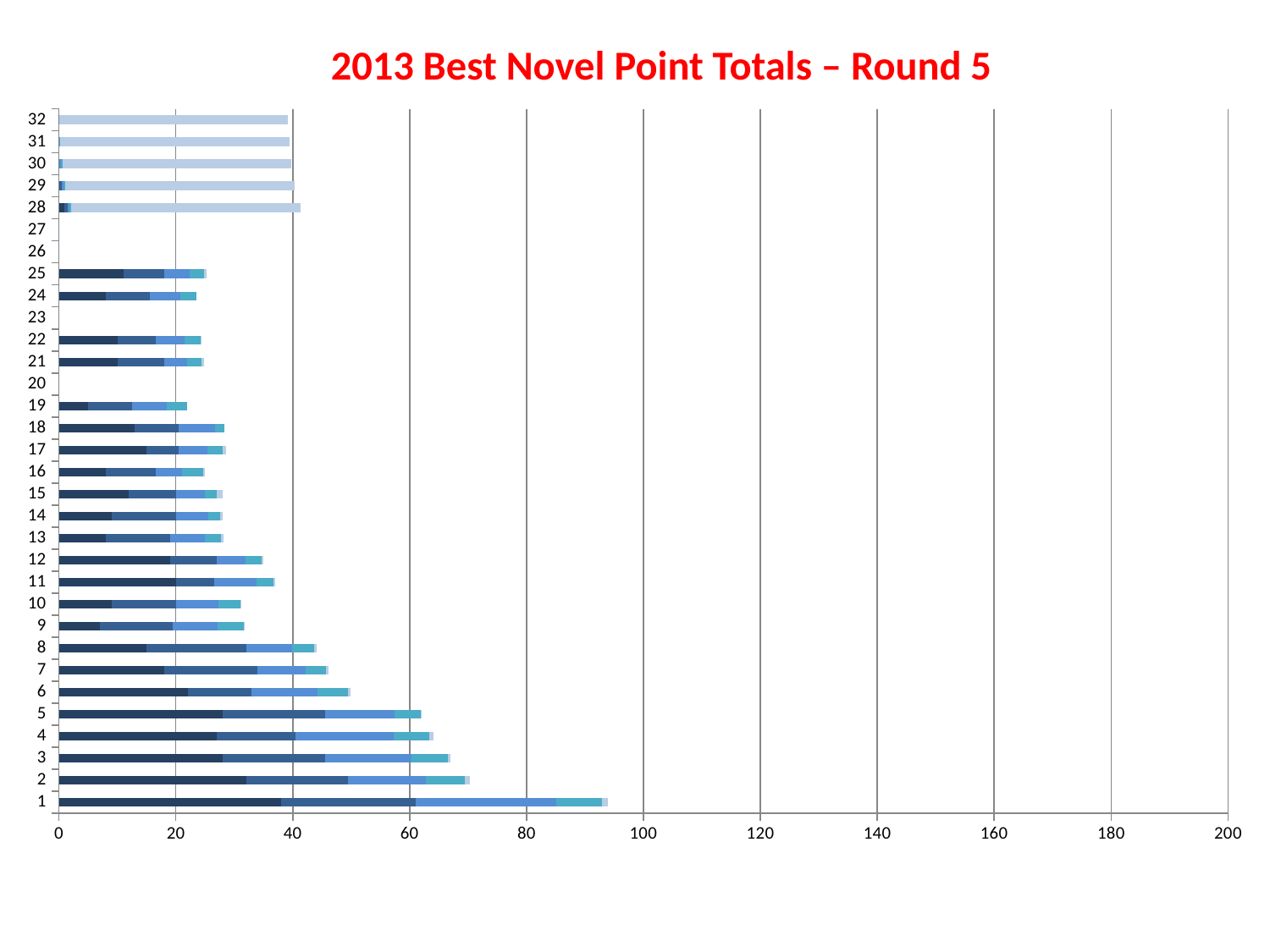
Which has the larger total, category 1 or category 2? 1 What is the title of the chart? 2013 Best Novel Point Totals – Round 5 Is the total for category 8 greater or less than 40? greater Which has the larger total, category 8 or category 9? 8 Is the total for category 2 greater or less than 60? greater How many categories are listed on the vertical axis of the chart? 32 What kind of chart is shown on the slide? bar chart Which category has the highest total in the chart? 1 What is the highest value shown on the horizontal axis? 200 Is the total for category 6 greater or less than 60? less